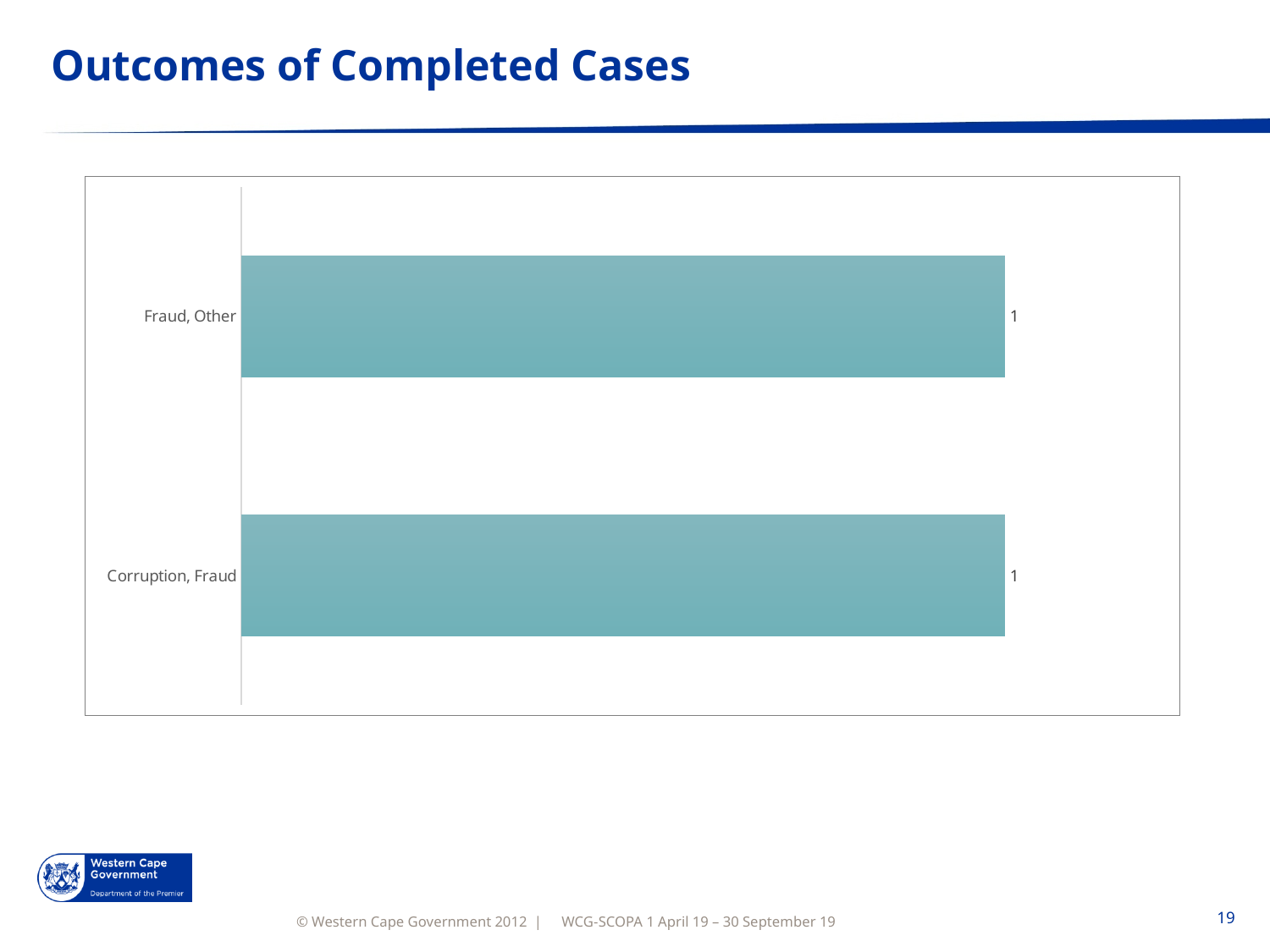
What is the total of the values for Fraud, Other and Corruption, Fraud? 2 What is the value for Corruption, Fraud? 1 What kind of chart is shown on the slide? Bar chart What is the value for Fraud, Other? 1 What is the difference between the values for Fraud, Other and Corruption, Fraud? 0 What is the title of the slide containing the chart? Outcomes of Completed Cases Are the bars in the chart horizontal or vertical? Horizontal How many categories are shown in the chart? 2